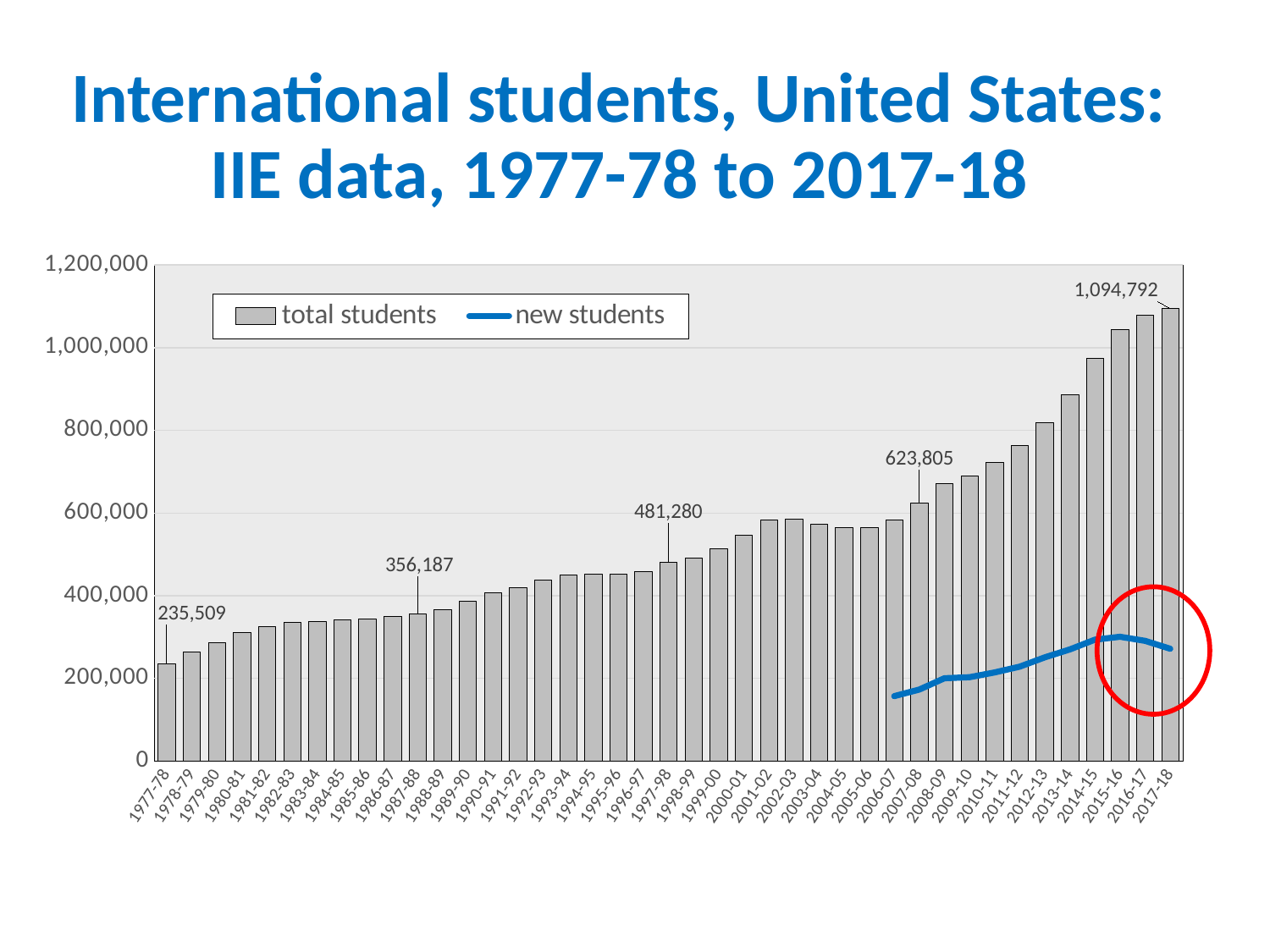
What is the difference in total students between 1997-98 and 1987-88? 125,093 Which year has the highest number of total students? 2017-18 What is the value for total students in 1977-78? 235,509 What is the value for total students in 1997-98? 481,280 What is the difference in total students between 2017-18 and 2007-08? 470,987 What is the overall trend of total students from 1977-78 to 2017-18? rising What is the value for total students in 2007-08? 623,805 Is the value for total students in 2013-14 greater or less than 800,000? greater How many series does the legend list? 2 Which year has the lowest number of total students? 1977-78 What is the value for total students in 1987-88? 356,187 What is the value for total students in 2017-18? 1,094,792